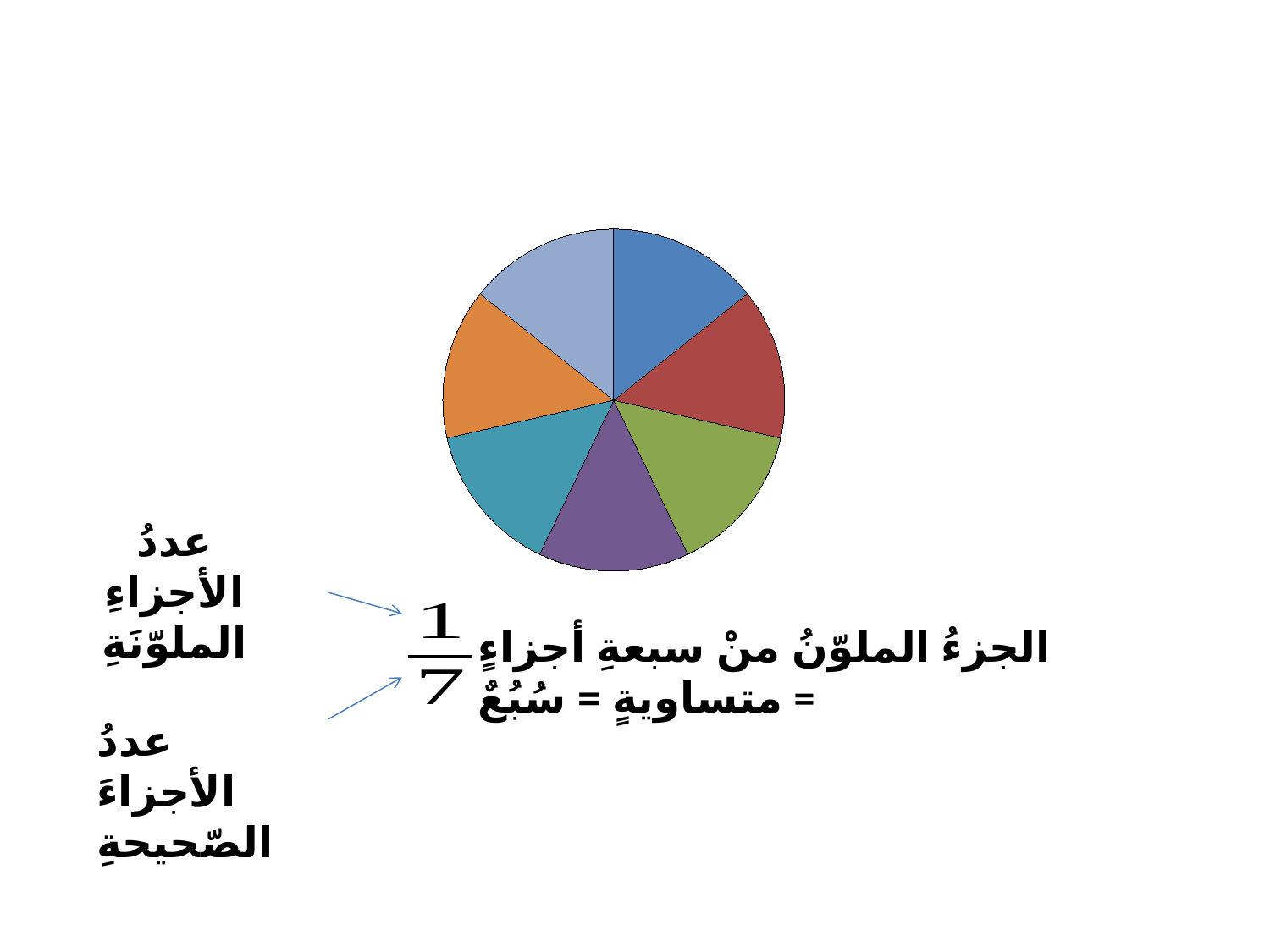
Are the slices of the pie chart equal in size? yes Does the pie chart have a legend? no What kind of chart is shown on the slide? pie chart How many slices does the pie chart have? 7 According to the slide, what fraction of the pie does one slice represent? 1/7